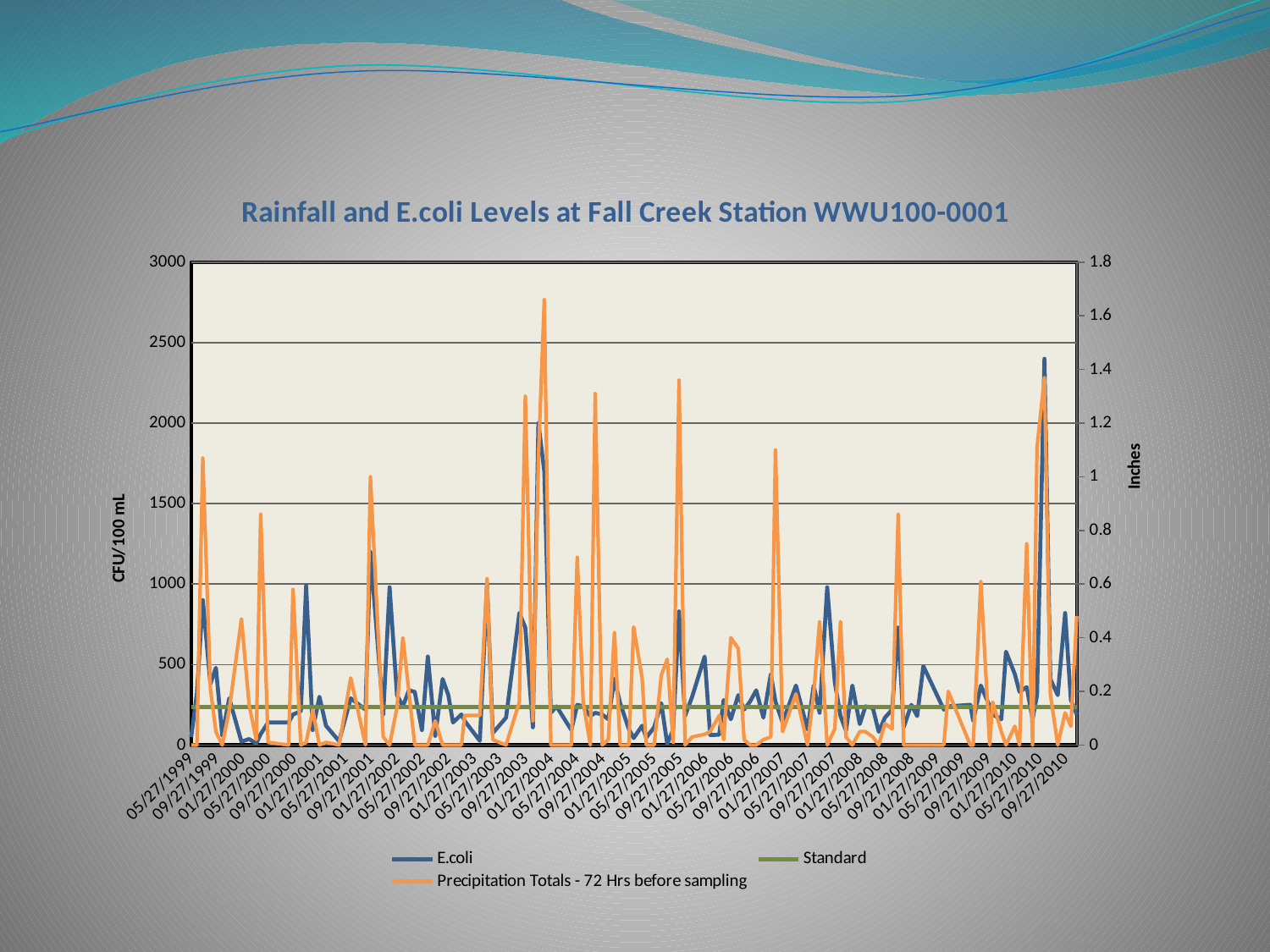
Which series is drawn in orange according to the legend? Precipitation Totals - 72 Hrs before sampling Which is larger: the precipitation peak near 01/27/2004 or the precipitation peak near 05/27/2010? The peak near 01/27/2004 What kind of chart is shown on the slide? Line chart Is the Standard line greater or less than 500 CFU/100 mL? less Which is larger: the E.coli peak near 05/27/2010 or the E.coli peak near 01/27/2004? The peak near 05/27/2010 What is the title of the chart? Rainfall and E.coli Levels at Fall Creek Station WWU100-0001 What is the highest tick value shown on the left vertical axis (CFU/100 mL)? 3000 Is the highest E.coli value on the chart greater or less than 2000 CFU/100 mL? greater Is the E.coli value at the peak near 01/27/2004 greater or less than 1500 CFU/100 mL? greater What is the highest tick value shown on the right vertical axis (Inches)? 1.8 How many series does the legend list? 3